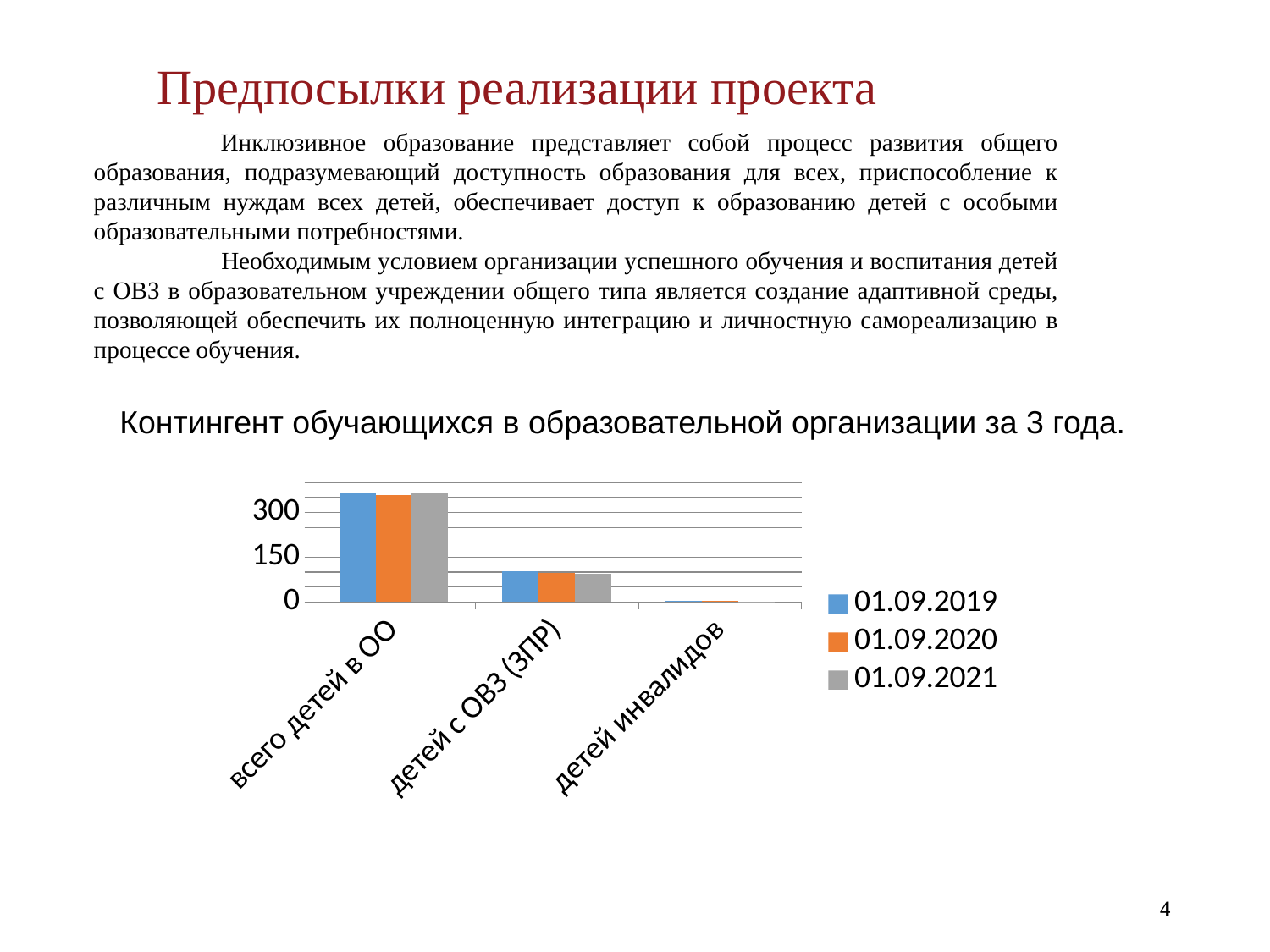
What are the three series listed in the chart legend? 01.09.2019, 01.09.2020, 01.09.2021 How many categories are shown on the x axis of the chart? 3 Which is larger on 01.09.2019: the value for 'детей с ОВЗ (ЗПР)' or for 'детей инвалидов'? детей с ОВЗ (ЗПР) Is the value for 'детей с ОВЗ (ЗПР)' on 01.09.2020 greater or less than 150? less Is the value for 'всего детей в ОО' on 01.09.2019 greater or less than 300? greater What is the title given above the chart? Контингент обучающихся в образовательной организации за 3 года. Which category has the highest values in the chart? всего детей в ОО What kind of chart is shown on the slide? bar chart Is the value for 'детей инвалидов' on 01.09.2021 greater or less than 150? less How many series does the chart legend list? 3 Which category has the lowest values in the chart? детей инвалидов Which is larger on 01.09.2021: the value for 'всего детей в ОО' or for 'детей с ОВЗ (ЗПР)'? всего детей в ОО